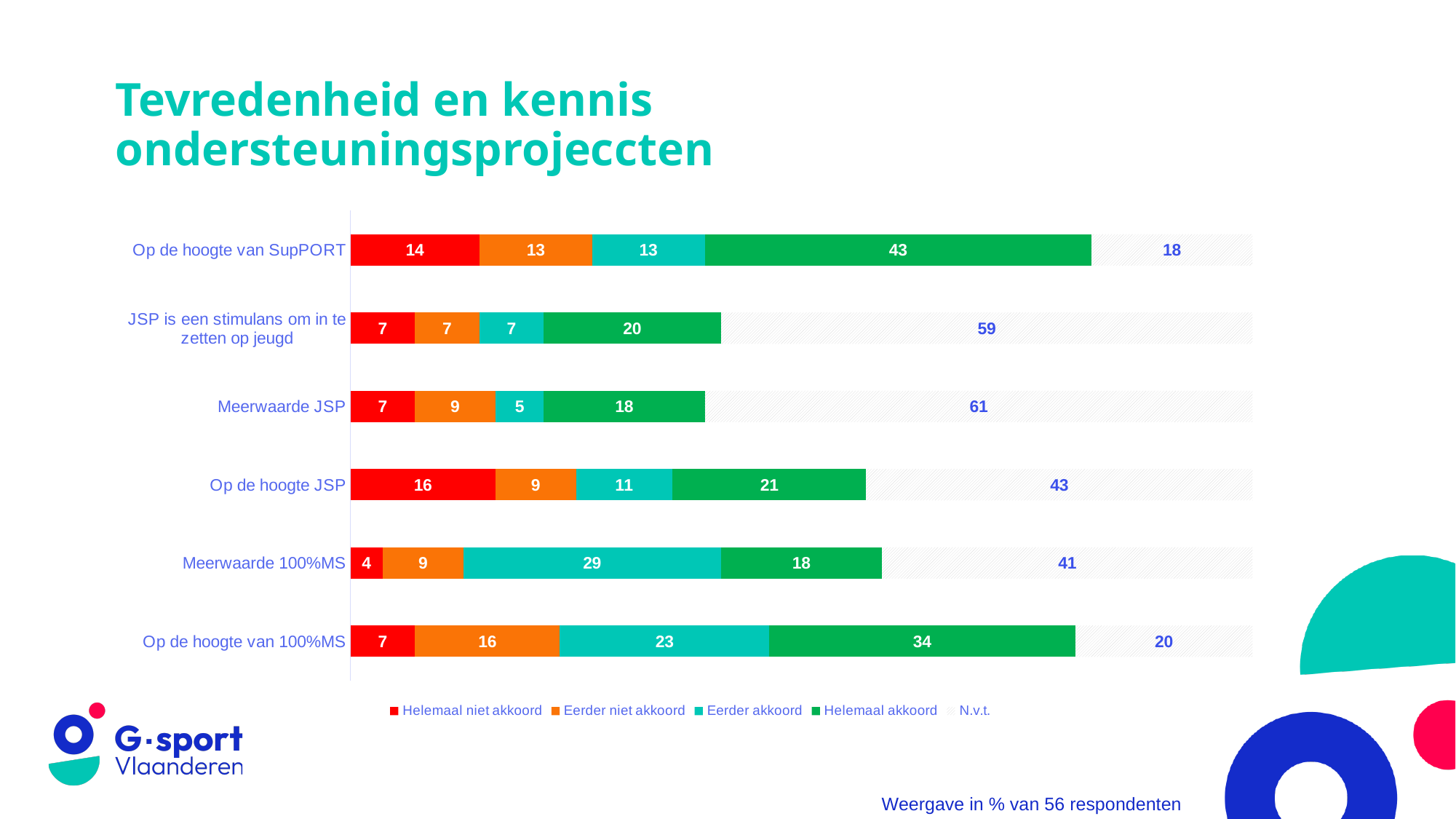
What is the 'Eerder akkoord' value for 'Meerwaarde 100%MS'? 29 How many categories (bars) are shown in the chart? 6 Which has the larger 'Eerder niet akkoord' value: 'Op de hoogte van 100%MS' or 'Op de hoogte JSP'? Op de hoogte van 100%MS What kind of chart is shown on the slide? Stacked bar chart How many series does the legend list? 5 Which category has the lowest 'Helemaal niet akkoord' value? Meerwaarde 100%MS What is the 'Helemaal niet akkoord' value for 'Op de hoogte JSP'? 16 What colour represents 'Helemaal akkoord' in the legend? Green Which category has the highest 'Helemaal akkoord' value? Op de hoogte van SupPORT How much larger is the 'N.v.t.' value for 'Meerwaarde JSP' than for 'Op de hoogte van SupPORT'? 43 What is the value for 'Helemaal akkoord' in the 'Op de hoogte van SupPORT' bar? 43 What is the 'N.v.t.' value for 'Meerwaarde JSP'? 61